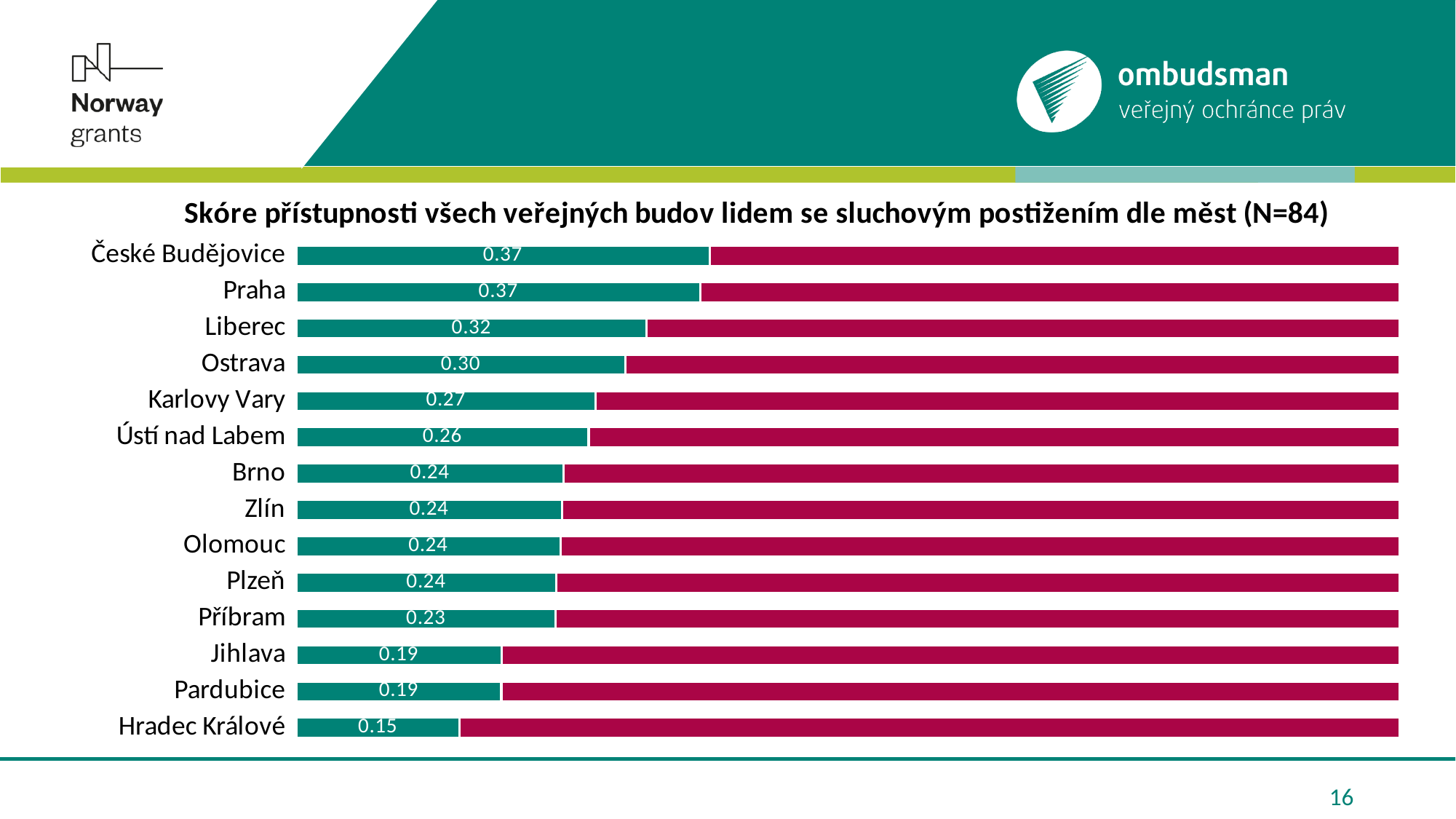
What is the accessibility score for Karlovy Vary? 0.27 What type of chart is shown on the slide? Bar chart Which city has the lowest accessibility score? Hradec Králové Which has a higher score, Liberec or Ostrava? Liberec How many cities are shown in the chart? 14 What is the accessibility score for Ústí nad Labem? 0.26 What is the title of the chart? Skóre přístupnosti všech veřejných budov lidem se sluchovým postižením dle měst (N=84) What is the highest accessibility score shown in the chart? 0.37 What is the accessibility score for Liberec? 0.32 What is the difference between the scores of Liberec and Hradec Králové? 0.17 What is the accessibility score for Hradec Králové? 0.15 What is the accessibility score for Ostrava? 0.30